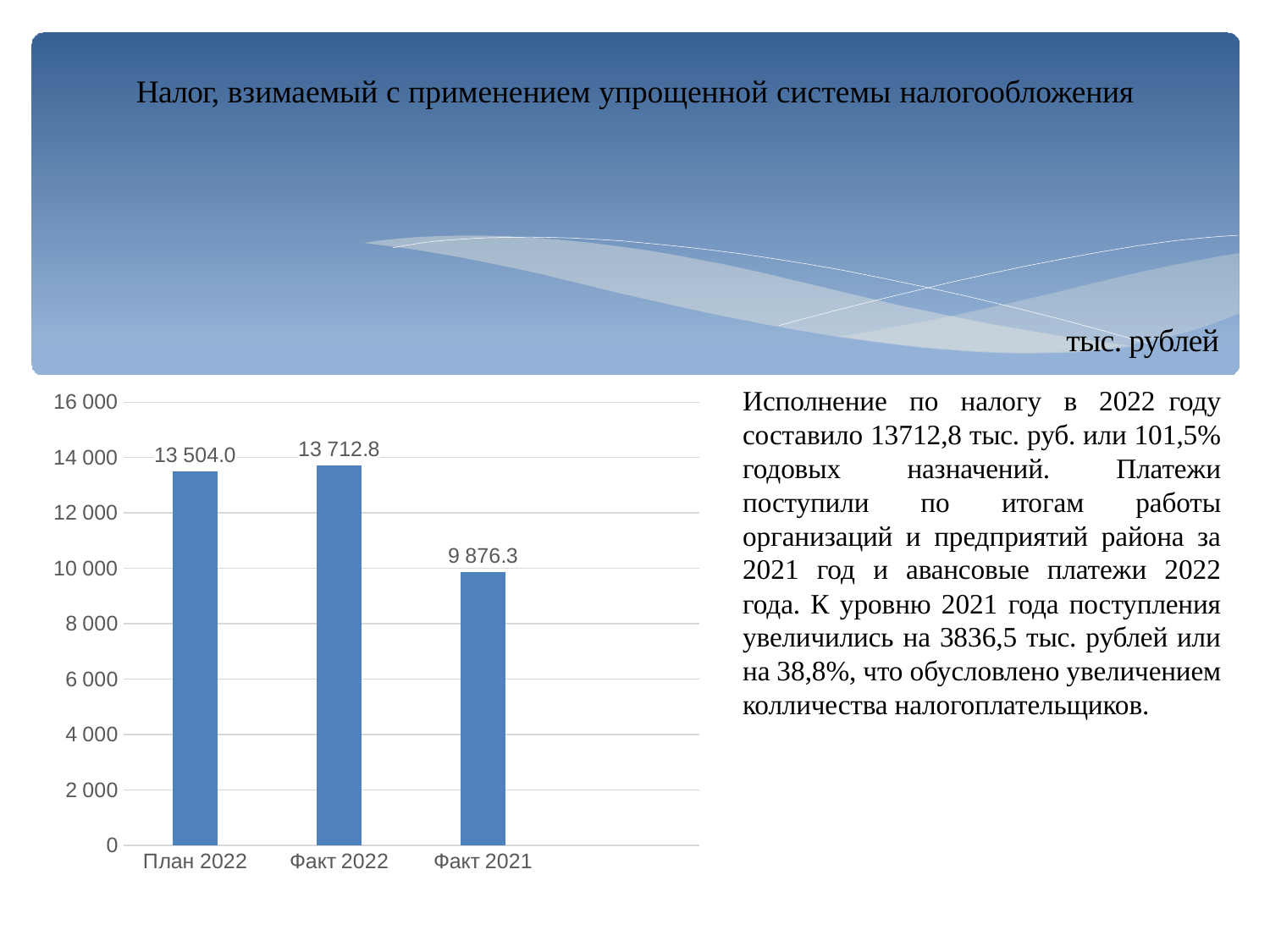
Which category has the lowest value? Факт 2021 Which category has the highest value? Факт 2022 What kind of chart is shown on the slide? bar chart How many categories are shown on the x axis? 3 What is the value for Факт 2021? 9 876.3 In what units are the chart values given, according to the slide? тыс. рублей What is the value for Факт 2022? 13 712.8 What is the value for План 2022? 13 504.0 What is the difference between the values for Факт 2022 and План 2022? 208.8 What is the difference between the values for Факт 2022 and Факт 2021? 3 836.5 Is the value for Факт 2021 greater or less than 10 000? less Which is larger, the value for Факт 2022 or the value for План 2022? Факт 2022